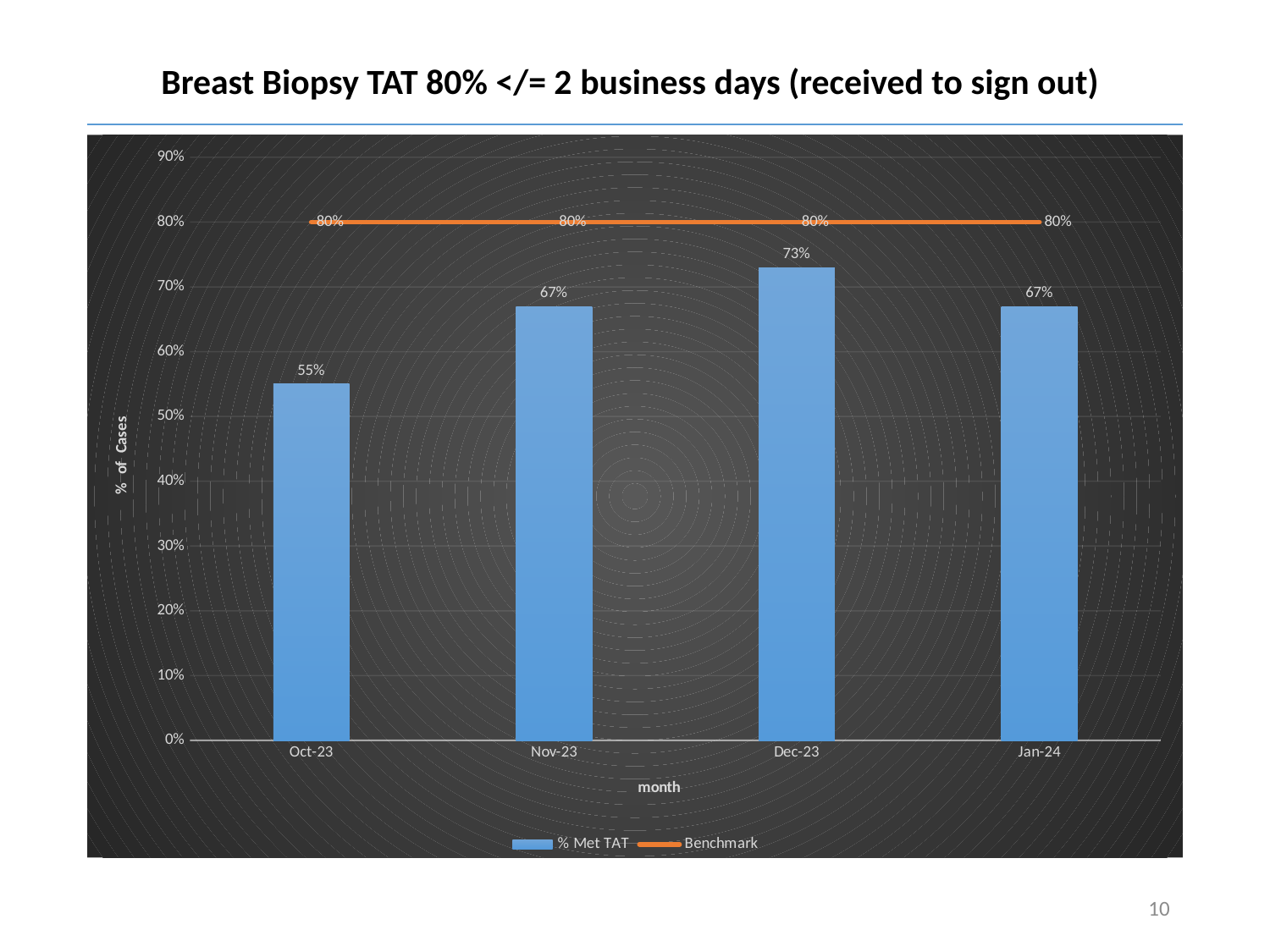
Which is larger, the % Met TAT for Nov-23 or for Dec-23? Dec-23 Which month has the lowest % Met TAT? Oct-23 What is the Benchmark value shown for Jan-24? 80% What is the title of the chart? Breast Biopsy TAT 80% </= 2 business days (received to sign out) What is the difference between the Benchmark and the % Met TAT for Dec-23? 7% Which month has the highest % Met TAT? Dec-23 What is the difference between the % Met TAT for Dec-23 and Oct-23? 18% What is the % Met TAT value for Dec-23? 73% How many series does the legend list? 2 How many months are shown on the x axis? 4 What is the % Met TAT value for Oct-23? 55% What kind of chart is used to show the % Met TAT values? Bar chart